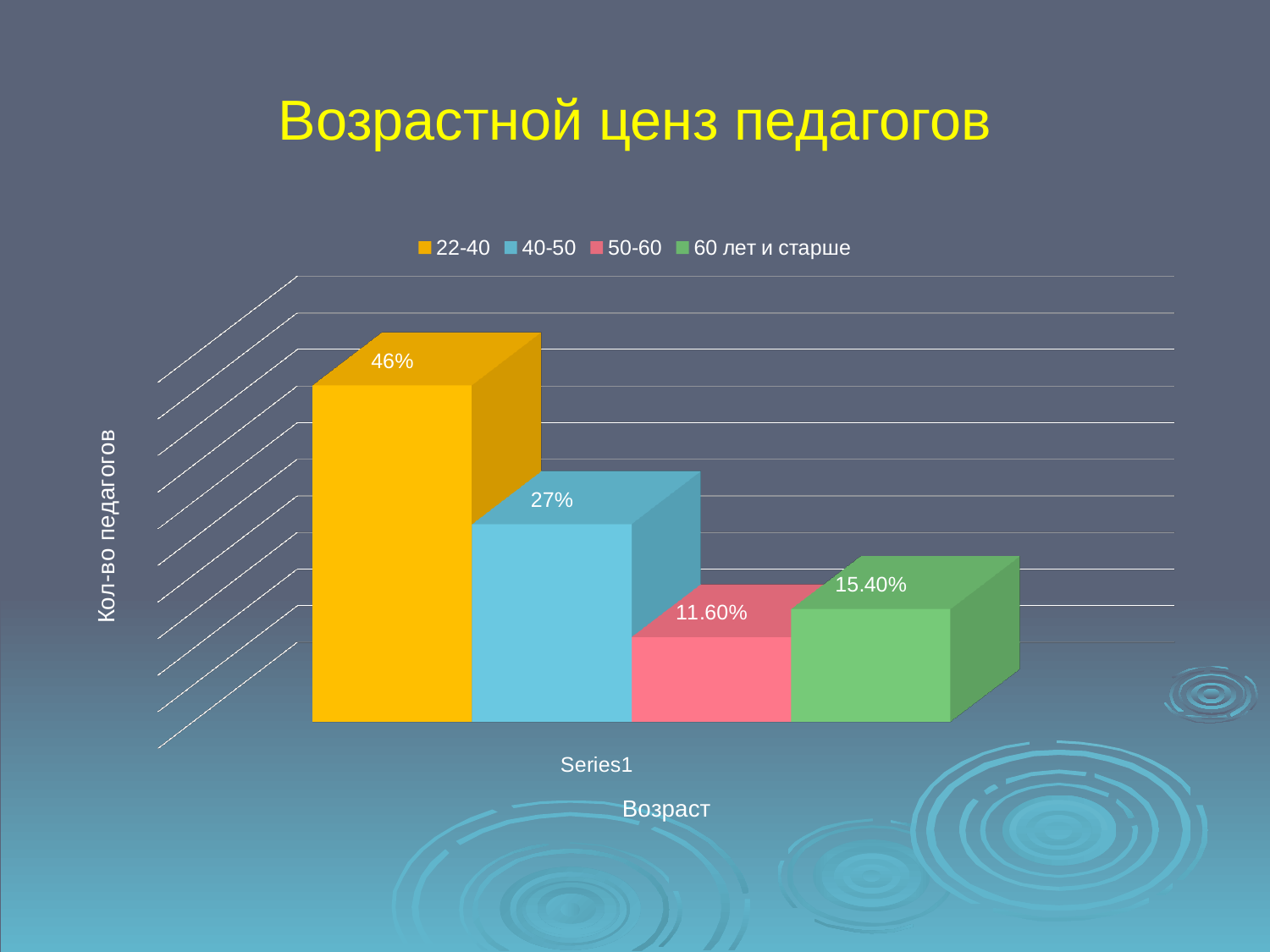
What is the difference between the values for the 22-40 and 40-50 age groups? 19% What is the value for the 40-50 age group? 27% Which age group has the lowest value? 50-60 What is the value for the 50-60 age group? 11.60% What is the difference between the values for the '60 лет и старше' and 50-60 age groups? 3.80% What is the title of the chart? Возрастной ценз педагогов Which is larger, the value for 40-50 or the value for '60 лет и старше'? 40-50 How many series does the legend list? 4 What is the value for the 22-40 age group? 46% What is the value for the '60 лет и старше' age group? 15.40% What kind of chart is shown on the slide? Bar chart Which age group has the highest value? 22-40